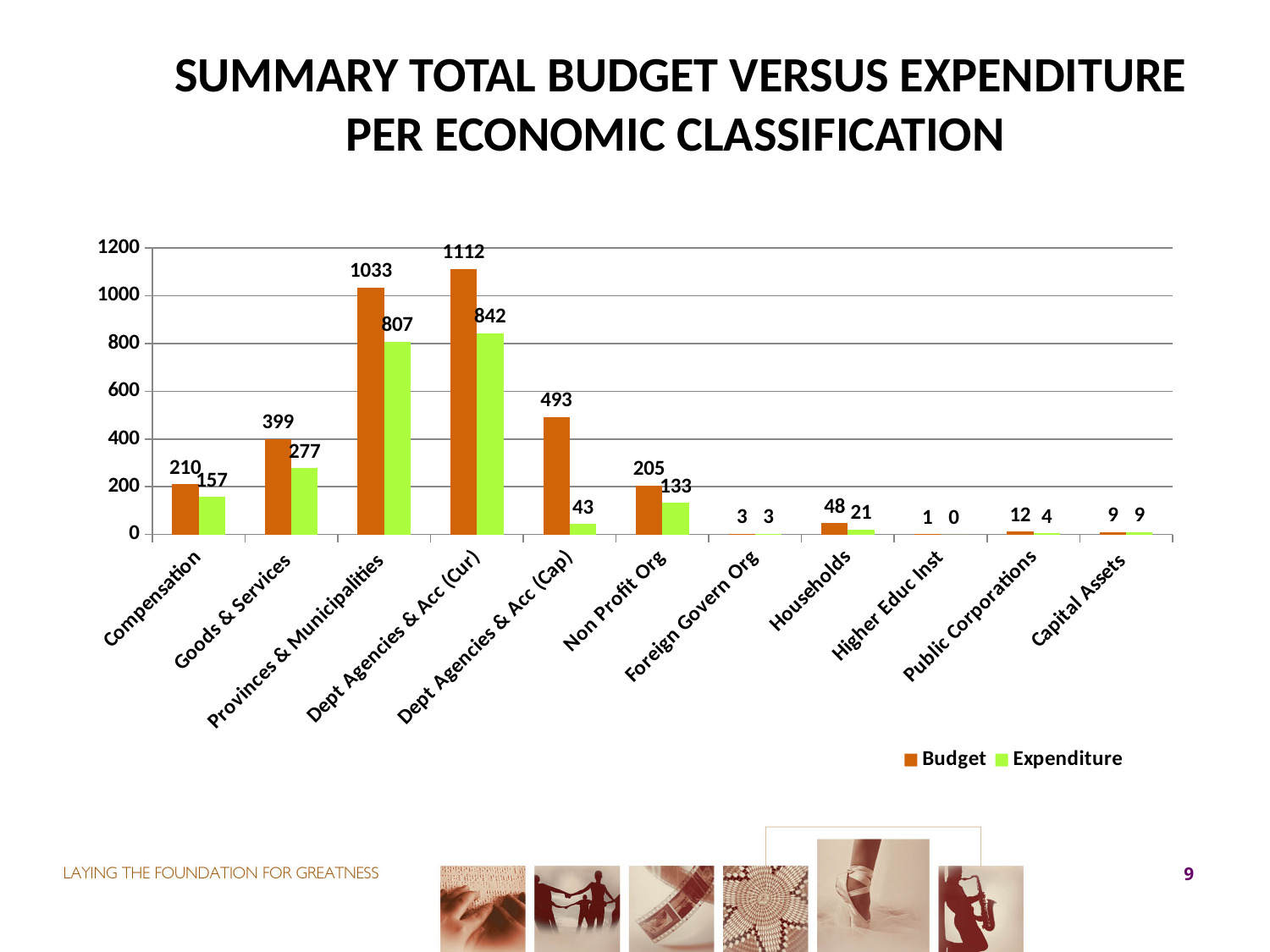
What is the Expenditure value for Dept Agencies & Acc (Cap)? 43 How many categories are shown on the x axis? 11 Which series is shown in green in the legend? Expenditure Which is larger, the Expenditure for Compensation or the Expenditure for Non Profit Org? Compensation What is the difference between the Budget and Expenditure values for Non Profit Org? 72 How many series does the legend list? 2 Which category has the highest Budget value? Dept Agencies & Acc (Cur) What is the Expenditure value for Dept Agencies & Acc (Cur)? 842 What is the Budget value for Provinces & Municipalities? 1033 What kind of chart is shown on the slide? Bar chart Which category has the lowest Expenditure value? Higher Educ Inst What is the difference between the Budget and Expenditure values for Goods & Services? 122